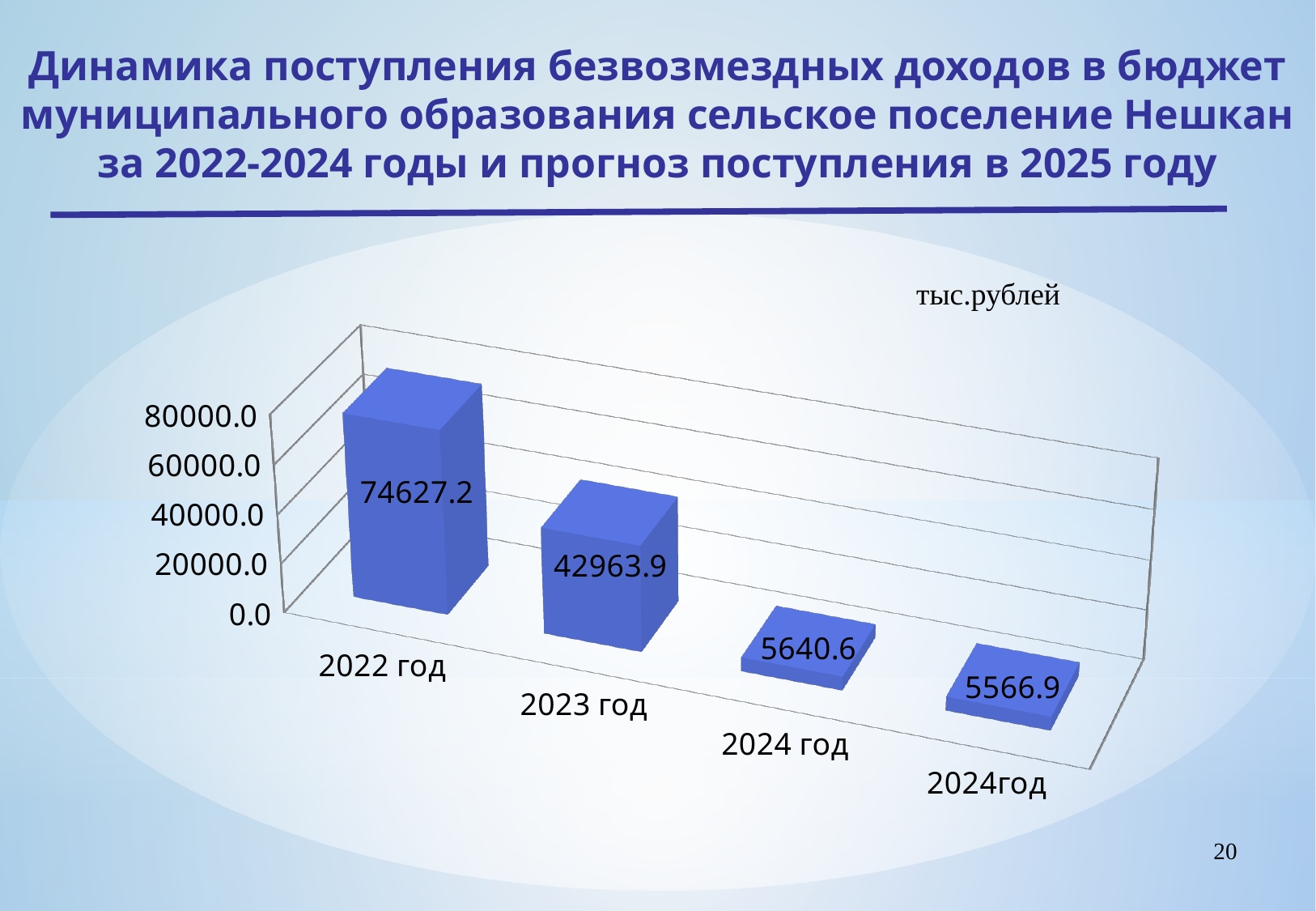
Which is larger, the value for 2022 год or the value for 2023 год? 2022 год How many bars (categories) does the chart show? 4 What is the difference between the values for 2022 год and 2023 год? 31663.3 Which category has the highest value? 2022 год What unit of measurement is indicated above the chart? тыс.рублей What is the value shown on the rightmost bar? 5566.9 Which bar has the lowest value? the rightmost bar (5566.9) What is the value shown for 2022 год? 74627.2 Do the values rise or fall from left to right along the x axis? fall What type of chart is shown on the slide? bar chart What is the value shown on the third bar from the left (labelled 2024 год)? 5640.6 What is the value shown for 2023 год? 42963.9